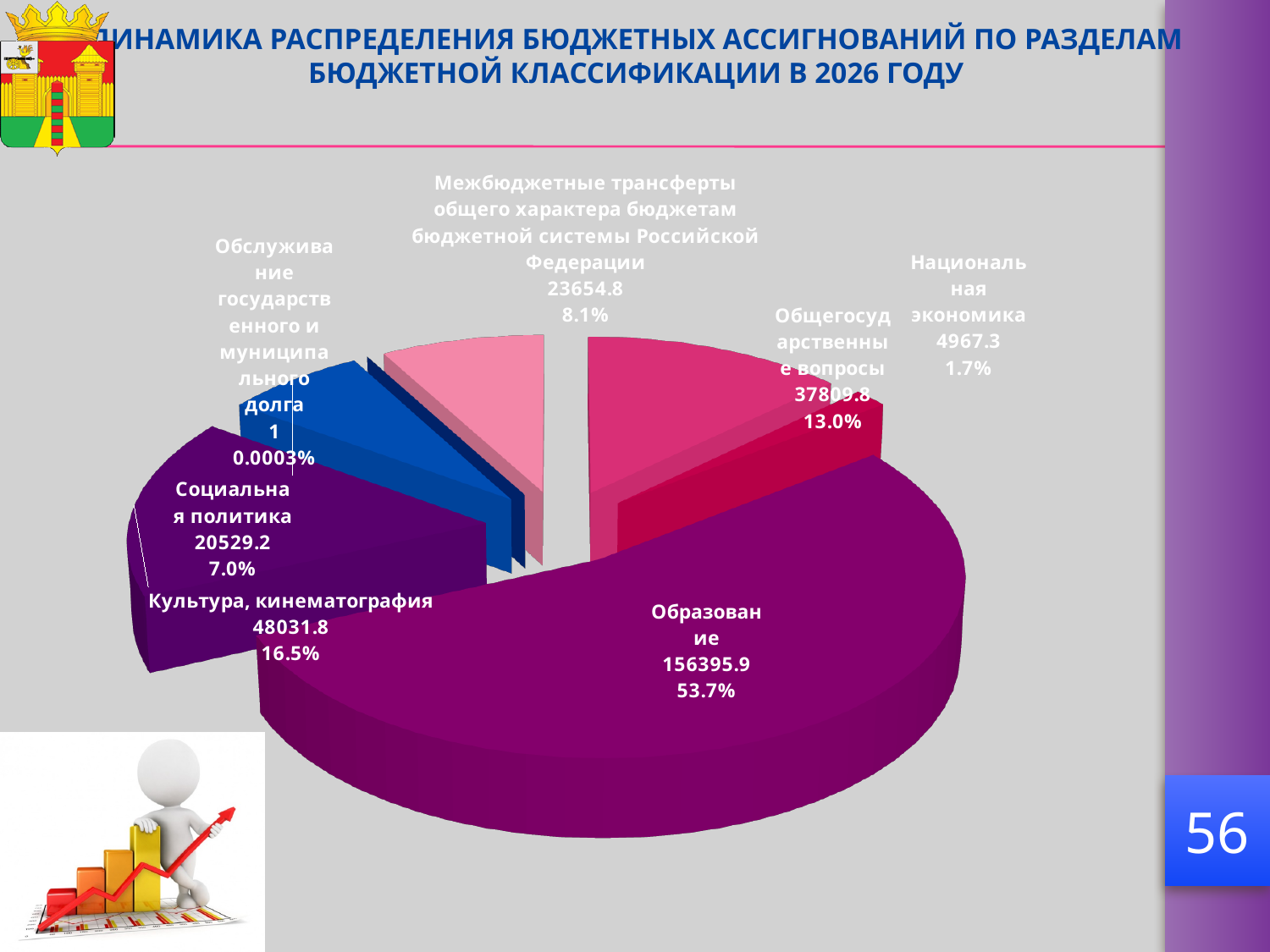
What is the value shown for Образование? 156395.9 What is the value shown for Общегосударственные вопросы? 37809.8 Which category has the largest slice of the pie? Образование What share of the pie does Культура, кинематография represent? 16.5% How many slices does the pie chart have? 7 Which category has the smallest slice of the pie? Обслуживание государственного и муниципального долга What percentage is shown for Национальная экономика? 1.7% What percentage is shown for Социальная политика? 7.0% Which is larger: the value for Межбюджетные трансферты общего характера or the value for Социальная политика? Межбюджетные трансферты общего характера Which year does the chart title refer to? 2026 What is the difference between the values for Культура, кинематография and Социальная политика? 27502.6 What kind of chart is shown on the slide? Pie chart